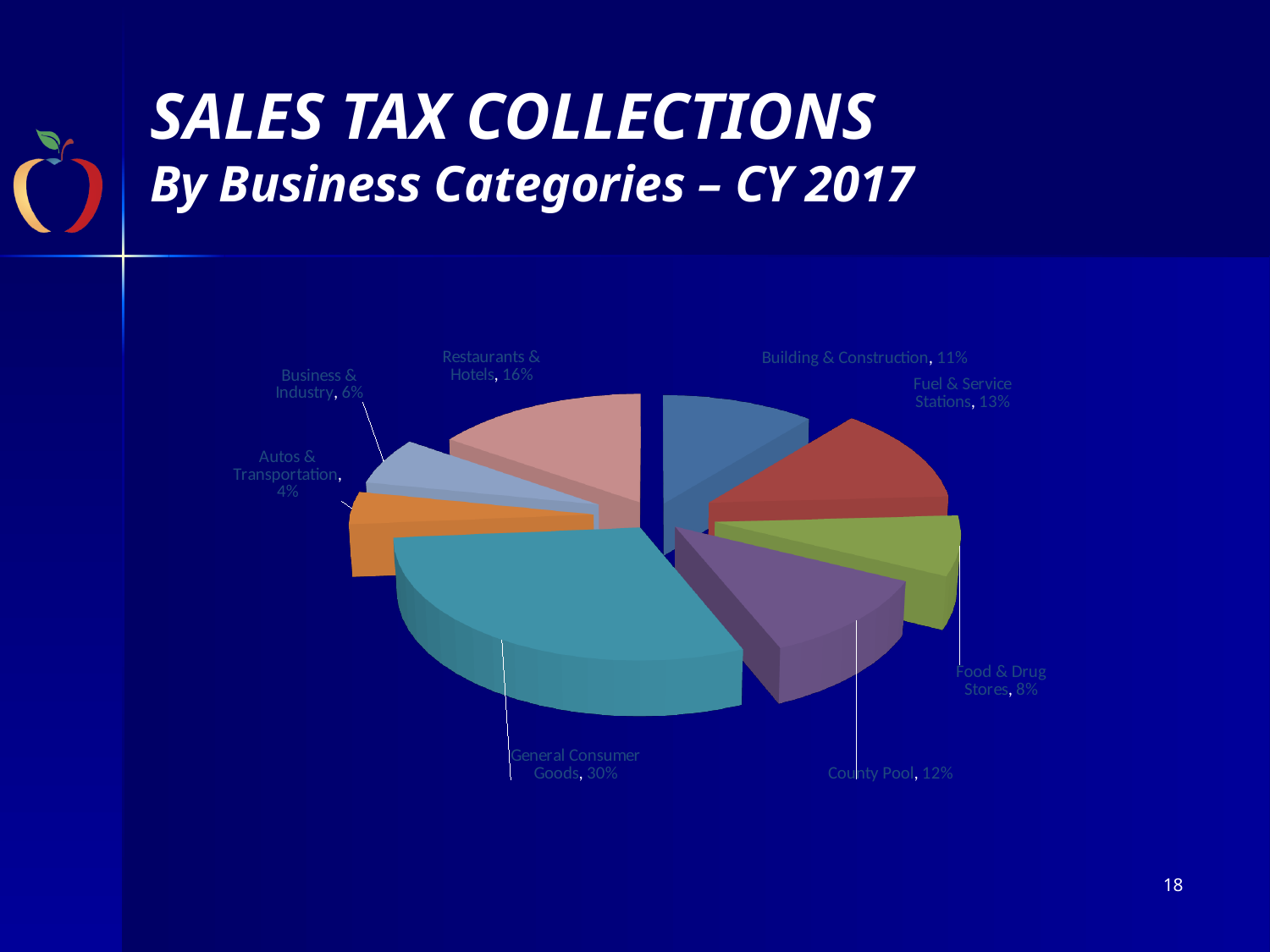
How many business categories are shown in the pie chart? 8 What is the combined share of Business & Industry and Autos & Transportation? 10% What kind of chart is shown on the slide? Pie chart What share of sales tax collections comes from County Pool? 12% What share of sales tax collections comes from Autos & Transportation? 4% What share of sales tax collections comes from Fuel & Service Stations? 13% Which has a larger share, Building & Construction or Food & Drug Stores? Building & Construction Which business category has the smallest share of sales tax collections? Autos & Transportation Which business category has the largest share of sales tax collections? General Consumer Goods What share of sales tax collections comes from Restaurants & Hotels? 16% What share of sales tax collections comes from General Consumer Goods? 30% What is the difference in percentage points between General Consumer Goods and Restaurants & Hotels? 14